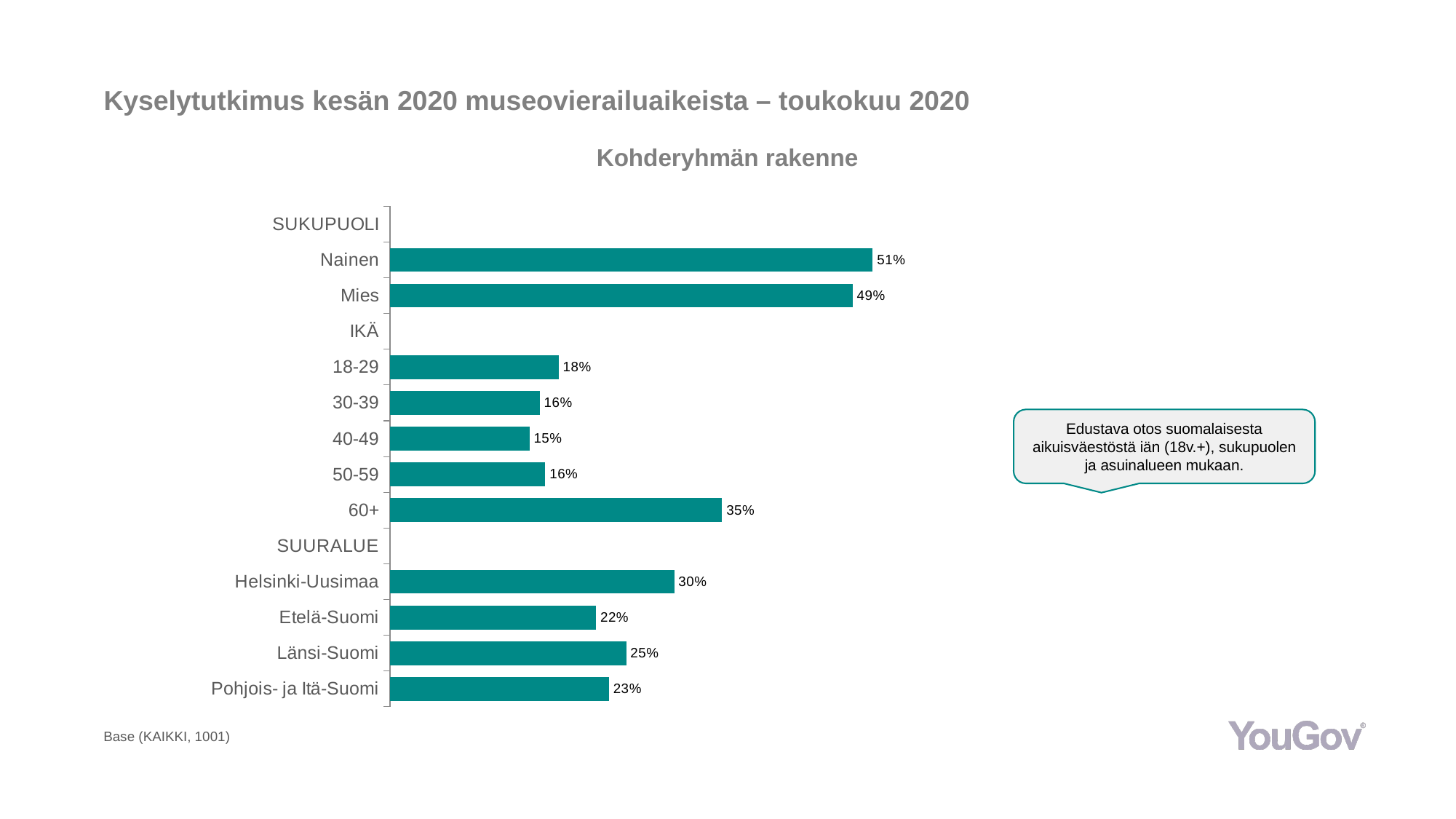
What kind of chart is shown on the slide? Bar chart What is the title of the chart? Kohderyhmän rakenne Which age group has the lowest value? 40-49 What is the difference between the values for Nainen and Mies? 2% What is the value for Pohjois- ja Itä-Suomi? 23% Which region (SUURALUE) has the lowest value? Etelä-Suomi Which age group has the highest value? 60+ What is the value for Nainen? 51% What is the difference between the values for 60+ and 18-29? 17% Which is larger, the value for Länsi-Suomi or Etelä-Suomi? Länsi-Suomi What is the value for Helsinki-Uusimaa? 30% What is the value for the 60+ age group? 35%